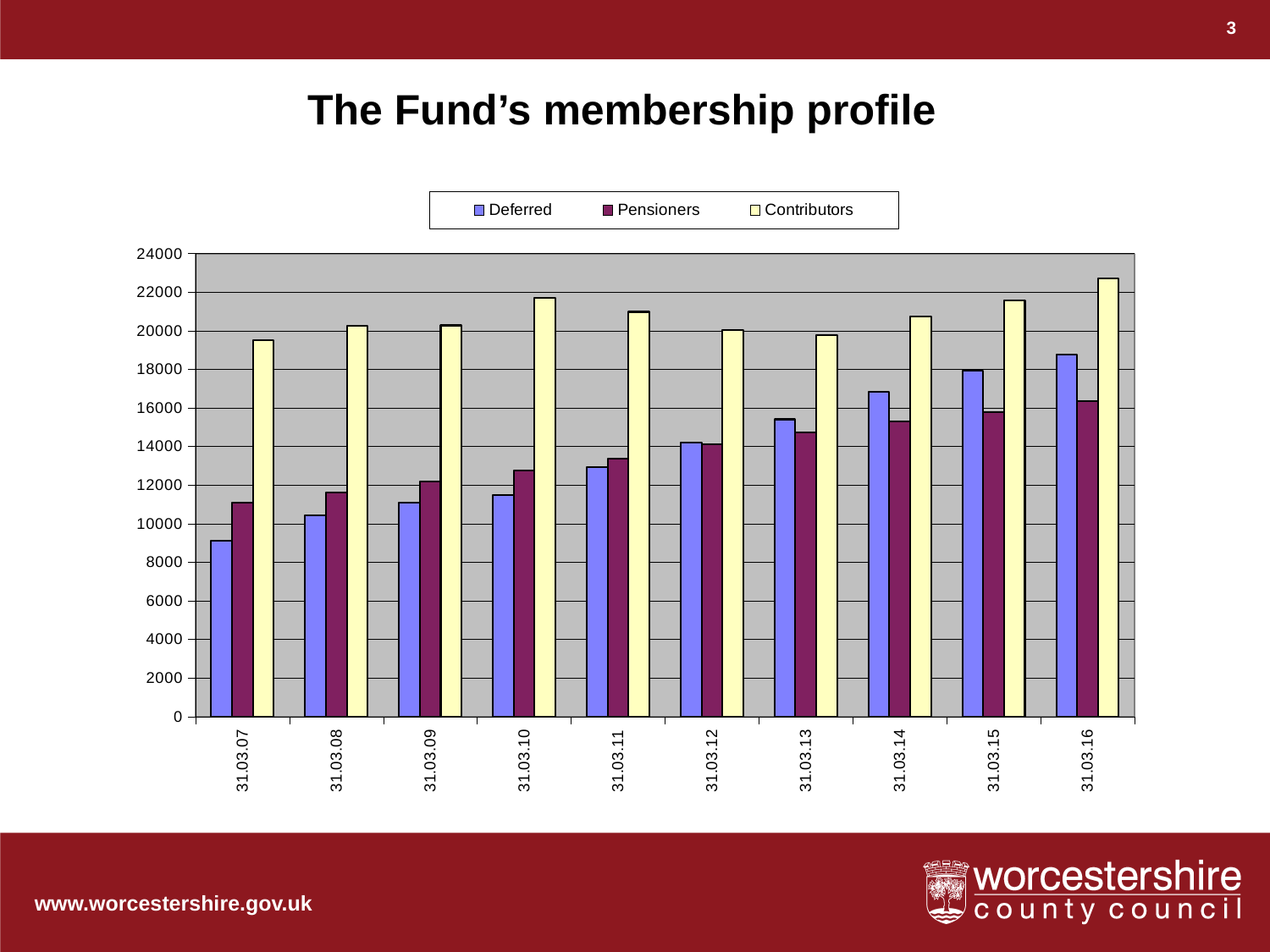
What is the title of the chart? The Fund's membership profile Is the Deferred value for 31.03.07 greater or less than 10000? less How many series does the legend list? 3 At which date is the Contributors value highest? 31.03.16 Does the Deferred series rise or fall from 31.03.07 to 31.03.16? rise What kind of chart is shown on the slide? bar chart At 31.03.16, which is larger: Deferred or Pensioners? Deferred Is the Contributors value for 31.03.16 greater or less than 22000? greater At which date is the Deferred value lowest? 31.03.07 Is the Pensioners value for 31.03.10 greater or less than 12000? greater How many dates are shown along the x axis? 10 At 31.03.07, which is larger: Deferred or Pensioners? Pensioners